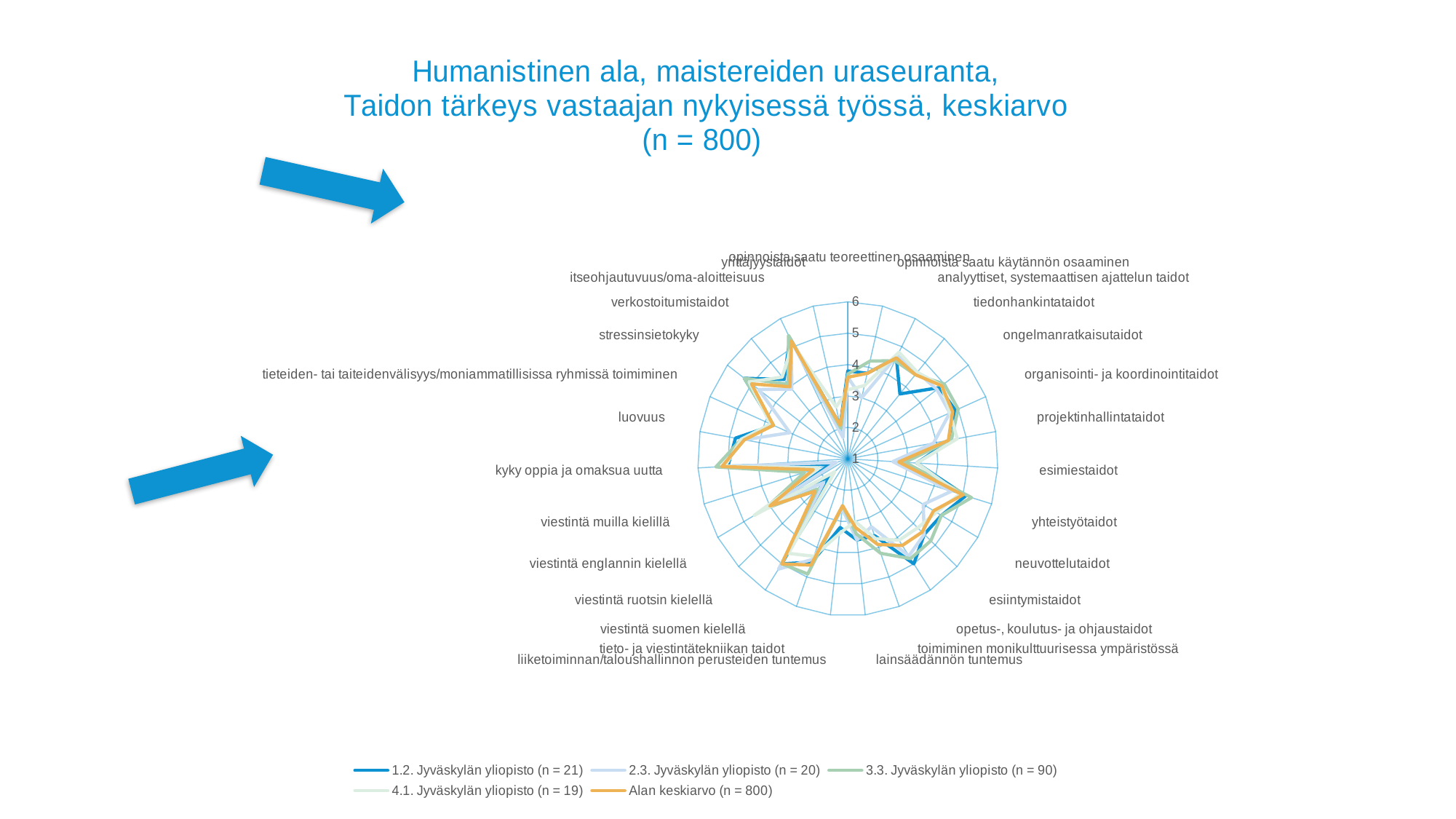
Is the value of 'Alan keskiarvo (n = 800)' for 'lainsäädännön tuntemus' greater or less than 4? less How many series does the legend list? 5 What kind of chart is shown on the slide? Radar chart What is the highest value shown on the radial axis of the chart? 6 How many skill categories are plotted around the radar chart? 27 Is the value of 'Alan keskiarvo (n = 800)' for 'kyky oppia ja omaksua uutta' greater or less than 4? greater Is the value of 'Alan keskiarvo (n = 800)' for 'esimiestaidot' greater or less than 4? less Which is larger for 'Alan keskiarvo (n = 800)': the value for 'kyky oppia ja omaksua uutta' or the value for 'esimiestaidot'? kyky oppia ja omaksua uutta What is the sample size (n) given in the chart title? 800